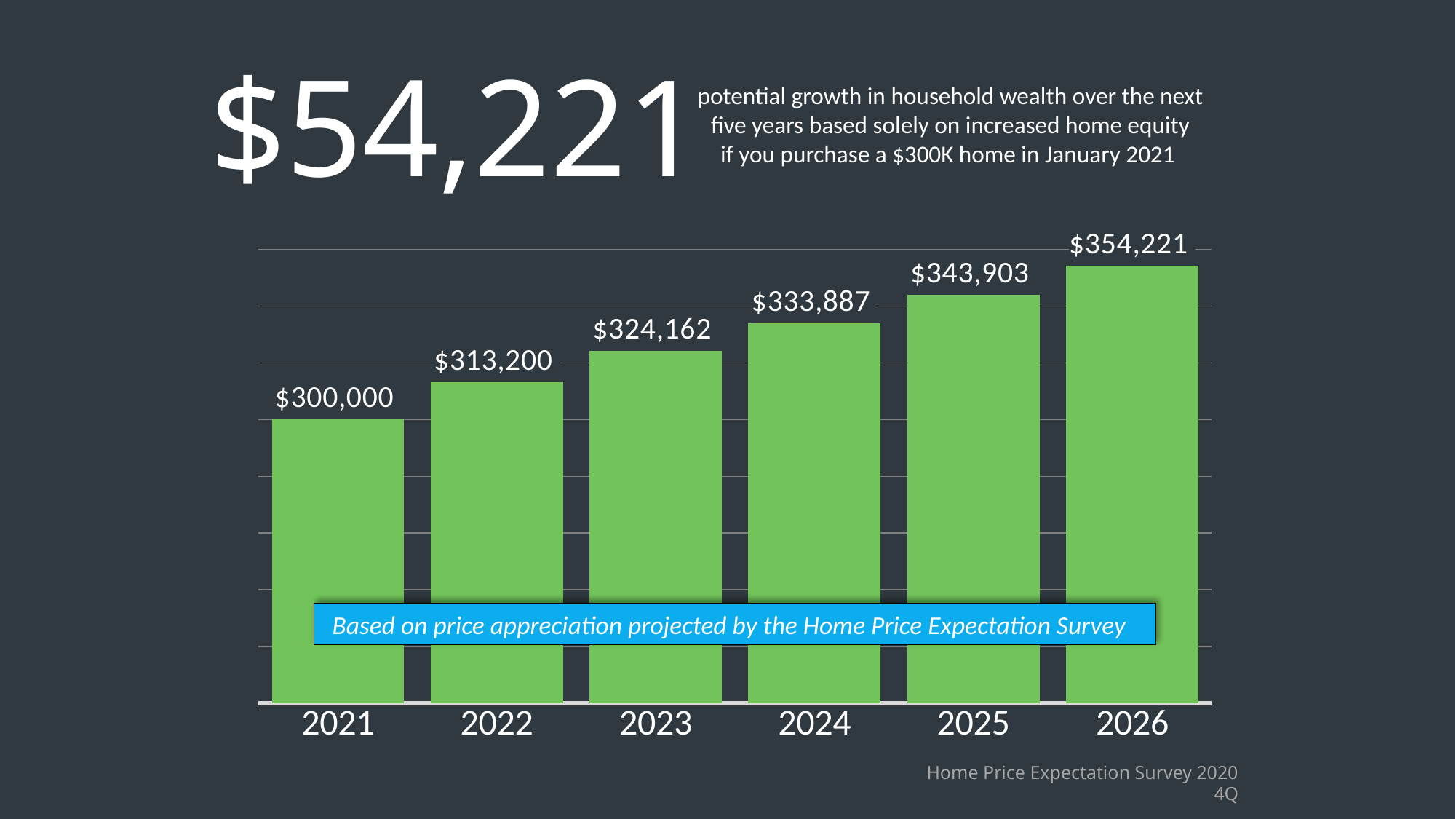
What is the value shown for 2023? $324,162 What is the value shown for 2025? $343,903 What is the difference between the values for 2026 and 2021? $54,221 What is the value shown for 2026? $354,221 Which year has the lowest value? 2021 What is the difference between the values for 2022 and 2021? $13,200 Which is larger, the value for 2024 or the value for 2022? 2024 Which year has the highest value? 2026 Do the values rise or fall from 2021 to 2026? Rise How many years are shown on the x axis? 6 What kind of chart is this? Bar chart What is the value shown for 2021? $300,000